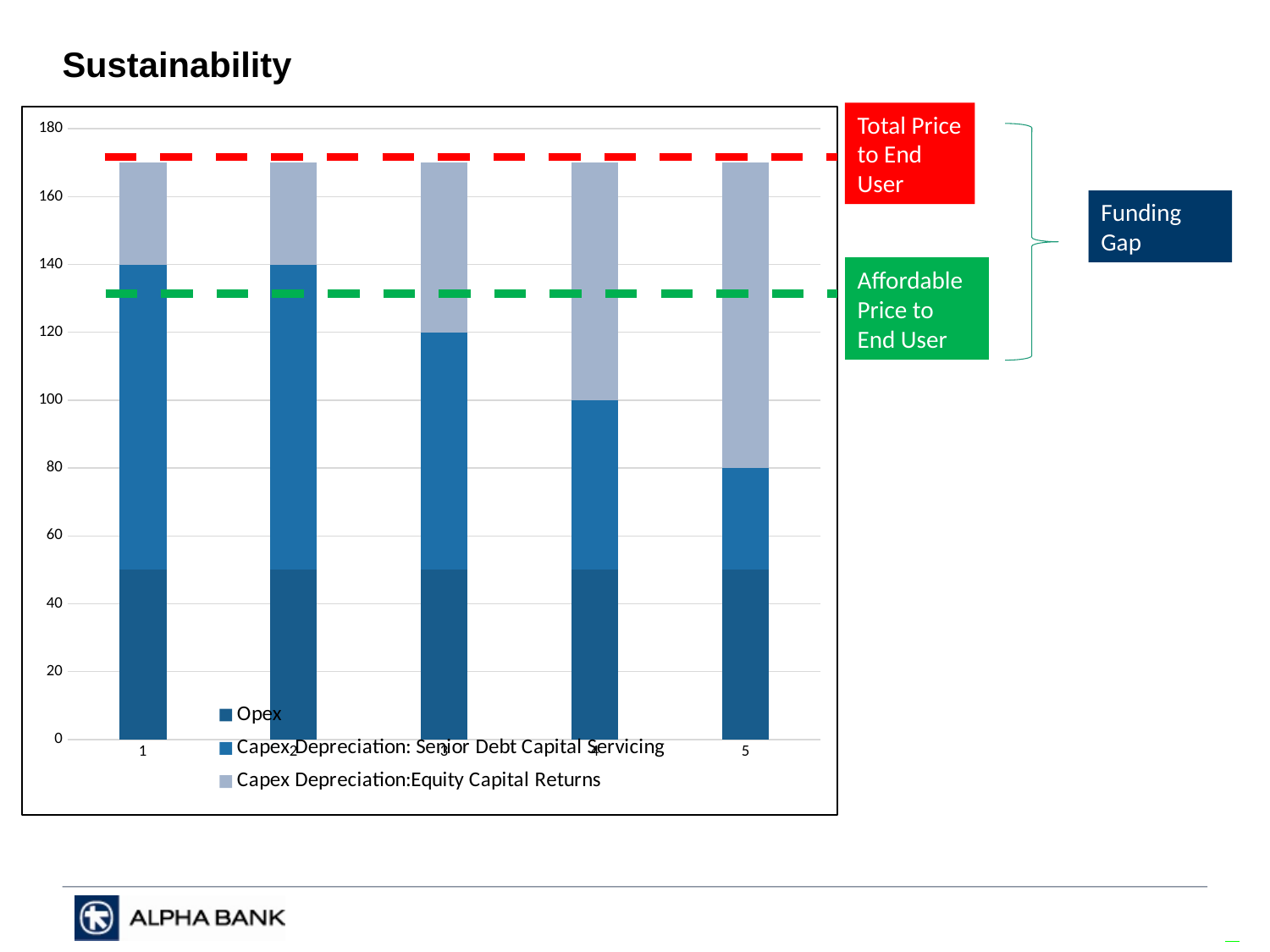
Which series is shown in the lightest (grey-blue) colour at the top of each bar? Capex Depreciation:Equity Capital Returns What kind of chart is shown on the slide? Stacked bar chart Is the Opex value for category 1 greater or less than 40? greater Is the total height of the stacked bar for category 1 greater or less than 160? greater Does the Capex Depreciation: Senior Debt Capital Servicing segment rise or fall from category 1 to category 5? fall Which category has the smallest Capex Depreciation: Senior Debt Capital Servicing segment? 5 Is the Opex value for category 3 greater or less than 60? less Which category has the largest Capex Depreciation:Equity Capital Returns segment? 5 How many categories are plotted along the x axis? 5 What does the red dashed line represent? Total Price to End User How many series does the legend list? 3